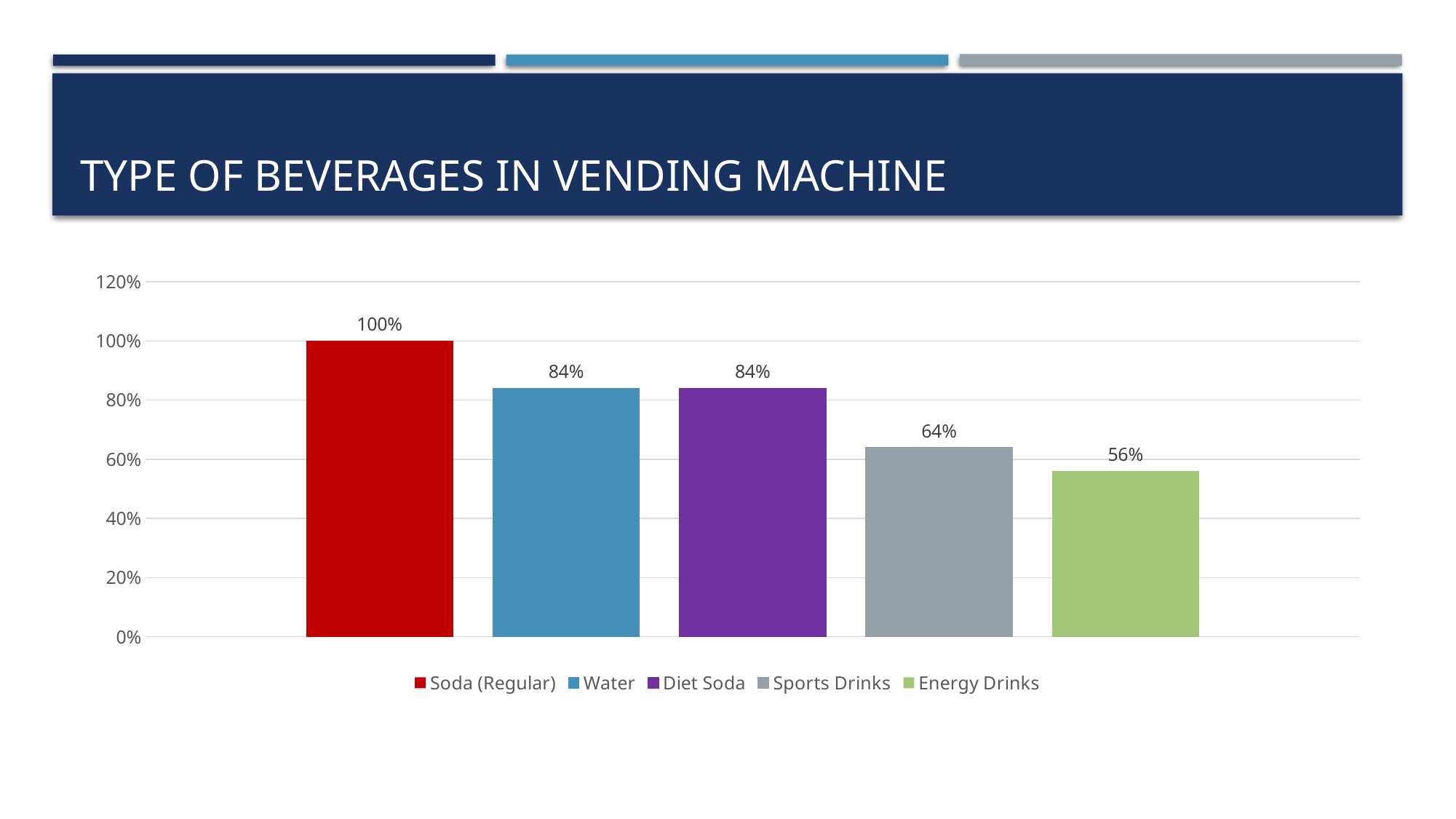
What is the value for Water? 84% What kind of chart is shown on the slide? Bar chart Which beverage type has the highest value? Soda (Regular) What is the difference between the values for Soda (Regular) and Energy Drinks? 44% What is the title of the slide? TYPE OF BEVERAGES IN VENDING MACHINE What is the value for Sports Drinks? 64% What is the value for Soda (Regular)? 100% Which beverage type has the lowest value? Energy Drinks Which is larger, the value for Water or the value for Sports Drinks? Water What is the difference between the values for Diet Soda and Sports Drinks? 20% What is the value for Energy Drinks? 56% How many beverage types are shown in the chart? 5